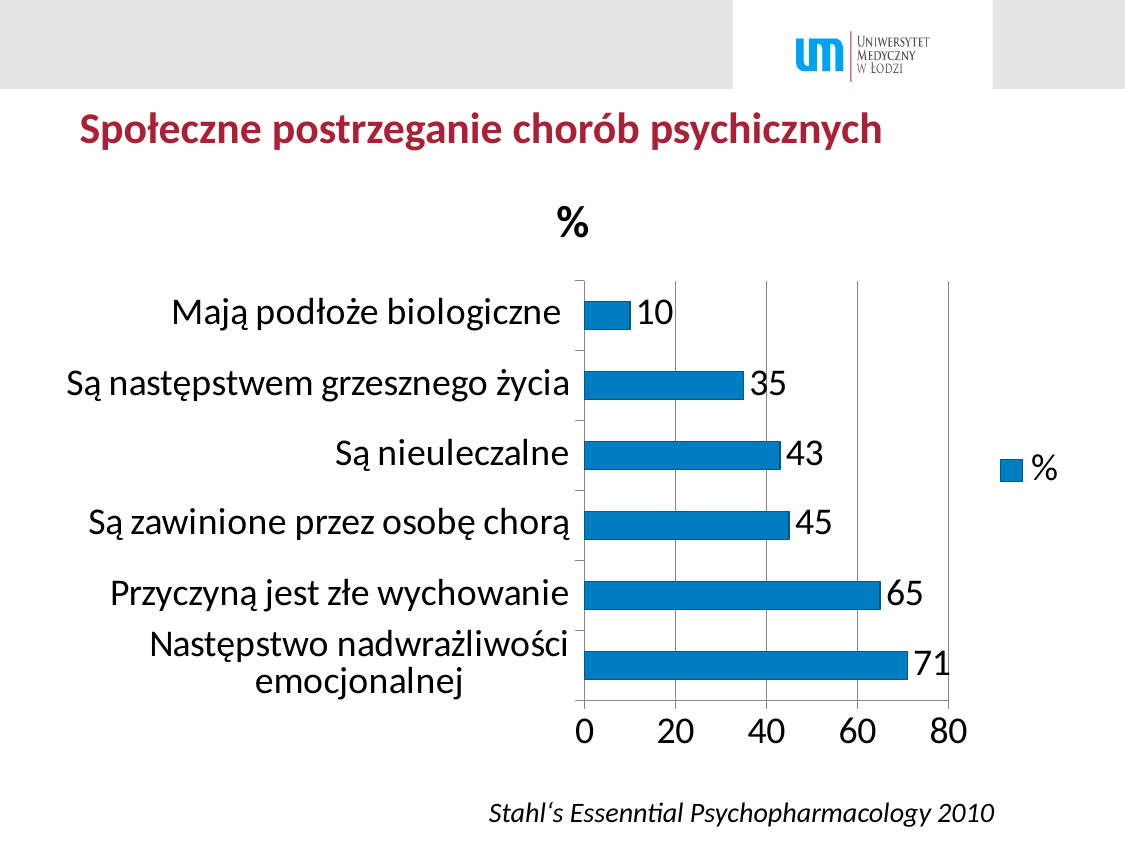
How many categories are shown in the chart? 6 Which is larger: the value for "Są zawinione przez osobę chorą" or for "Są nieuleczalne"? Są zawinione przez osobę chorą What is the difference between the values for "Przyczyną jest złe wychowanie" and "Są następstwem grzesznego życia"? 30 Is the value for "Przyczyną jest złe wychowanie" greater or less than 60? greater What kind of chart is shown on the slide? bar chart Which category has the lowest value? Mają podłoże biologiczne What is the title of the chart? % What is the value for "Są nieuleczalne"? 43 What is the value for "Następstwo nadwrażliwości emocjonalnej"? 71 How many series does the legend list? 1 Which category has the highest value? Następstwo nadwrażliwości emocjonalnej What is the value for "Mają podłoże biologiczne"? 10